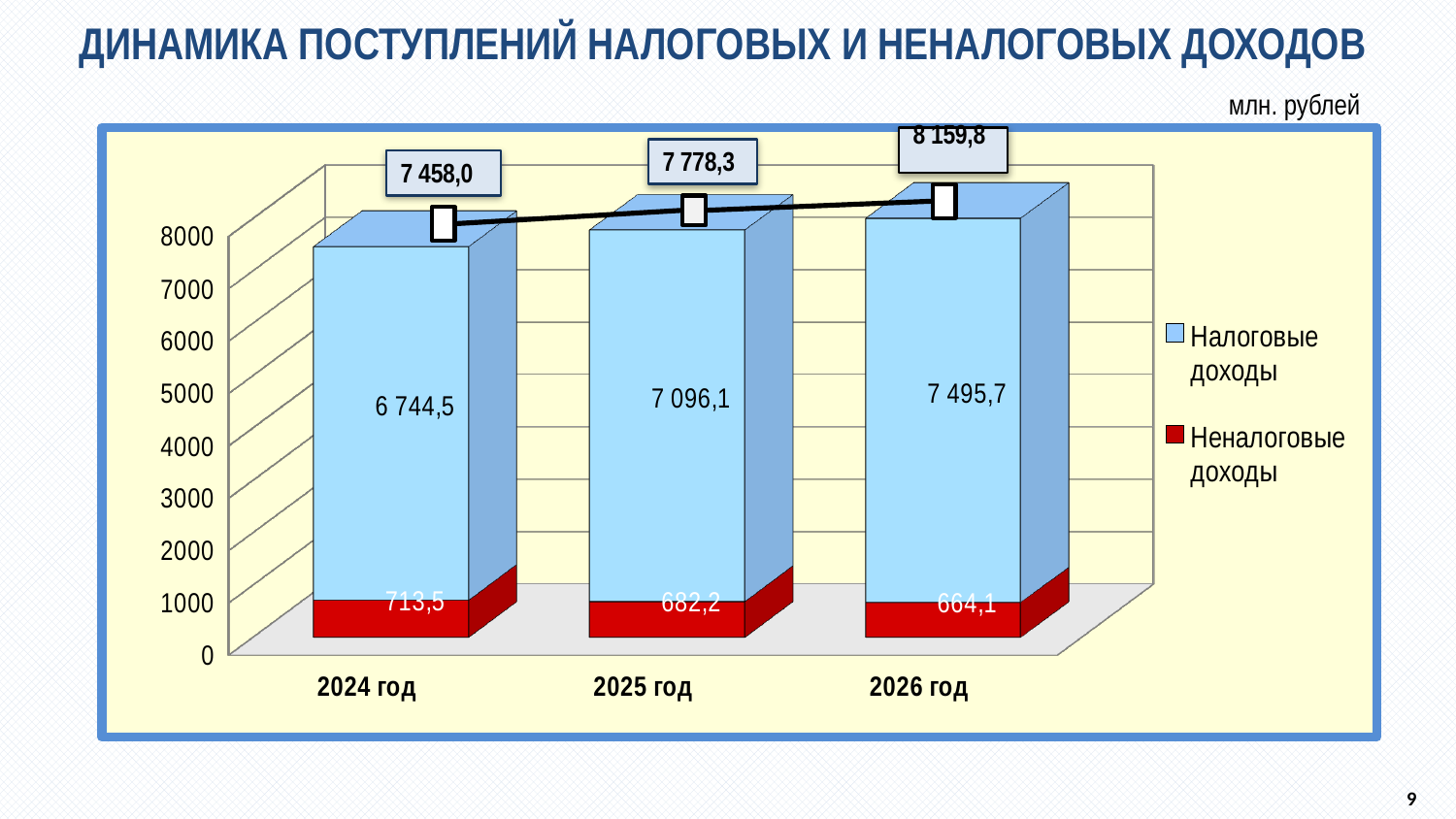
How many series does the legend list? 2 Which year has the lowest value of Неналоговые доходы? 2026 год What is the value of Неналоговые доходы for 2026 год? 664,1 What is the value of Налоговые доходы for 2024 год? 6 744,5 Which year has the highest value of Налоговые доходы? 2026 год How many years are shown on the x axis? 3 What is the total shown above the bar for 2025 год? 7 778,3 What is the difference between Налоговые доходы in 2026 год and 2024 год? 751,2 What is the value of Налоговые доходы for 2025 год? 7 096,1 Do the values of Налоговые доходы rise or fall from 2024 год to 2026 год? rise What kind of chart is shown on the slide? stacked bar chart Which is larger: Неналоговые доходы in 2024 год or in 2025 год? 2024 год